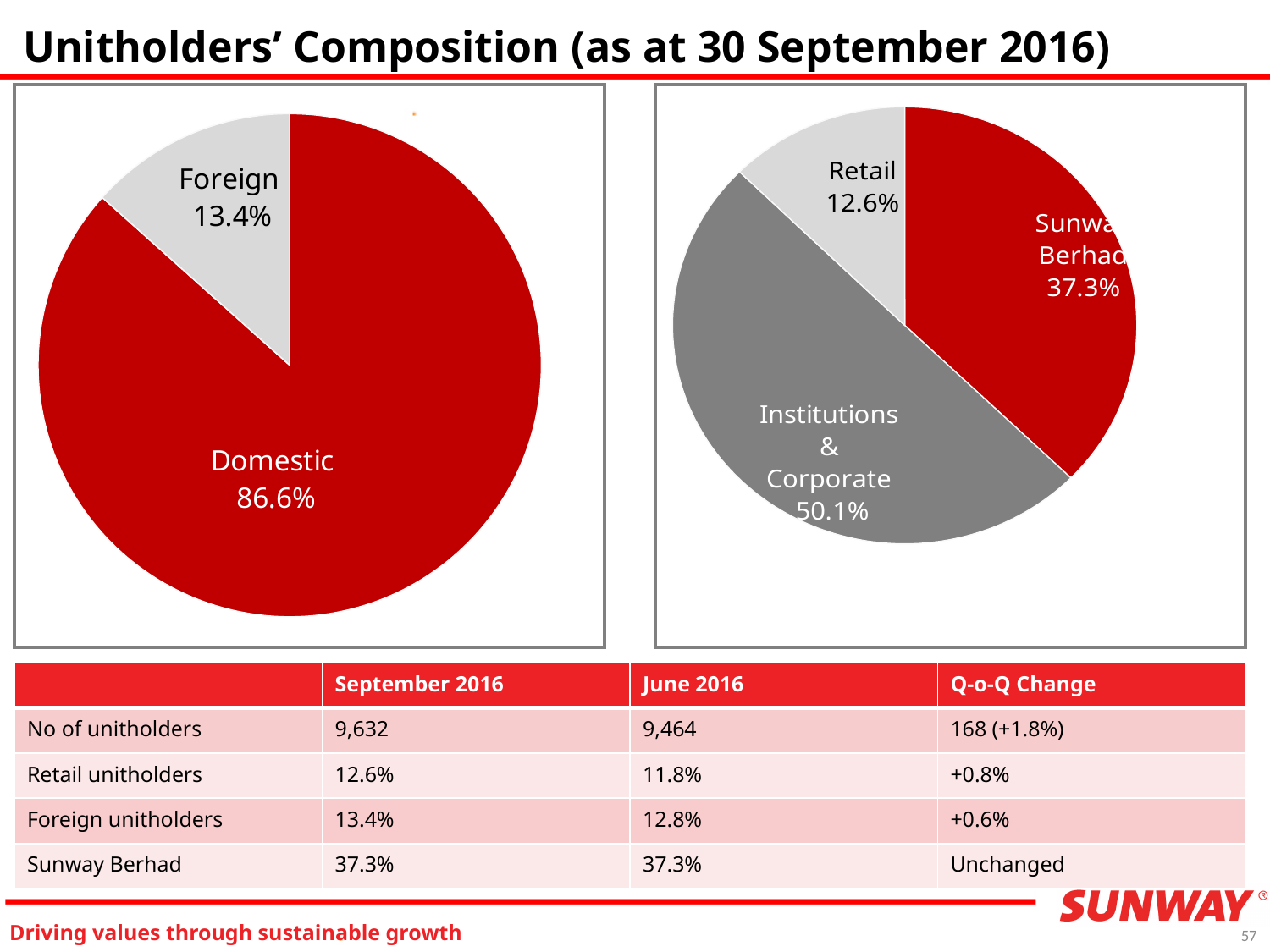
In the left pie chart, what is the difference in percentage points between the Domestic and Foreign slices? 73.2 percentage points In the right pie chart, which slice is the largest? Institutions & Corporate In the right pie chart, what colour is the Institutions & Corporate slice? Grey In the right pie chart, what share is labelled for Institutions & Corporate? 50.1% In the right pie chart, which slice is the smallest? Retail In the right pie chart, what share is labelled for Sunway Berhad? 37.3% What type of chart is the left chart on the slide? Pie chart In the right pie chart, what share is labelled for Retail? 12.6% In the right pie chart, which is larger: the Sunway Berhad slice or the Retail slice? Sunway Berhad How many slices does the right pie chart have? 3 In the left pie chart, what share is labelled for Domestic? 86.6% In the left pie chart, what share is labelled for Foreign? 13.4%